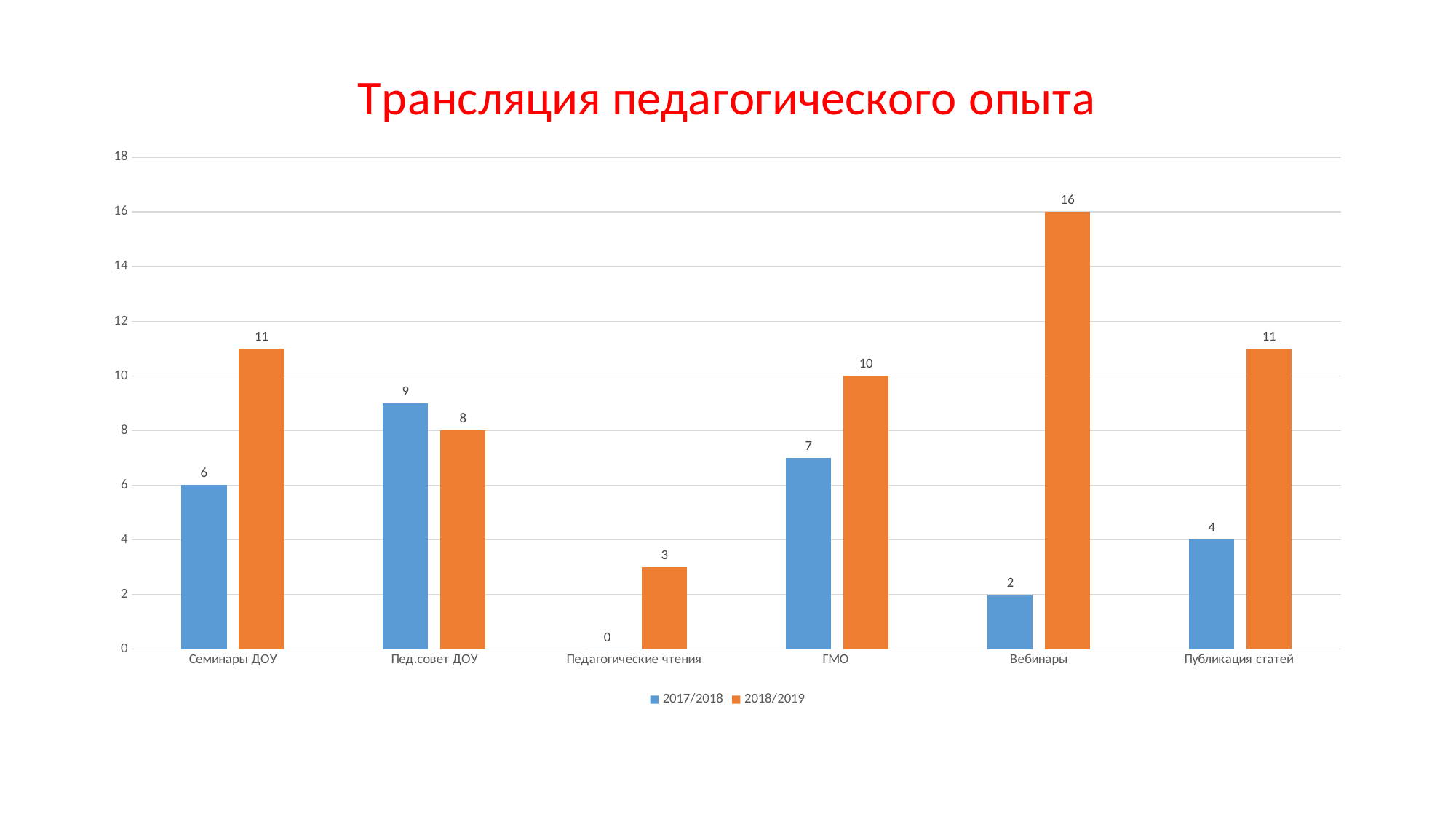
What is the value for Педагогические чтения in the 2017/2018 series? 0 What is the title of the chart? Трансляция педагогического опыта What is the value for Вебинары in the 2018/2019 series? 16 What is the difference between the 2018/2019 and 2017/2018 values for Вебинары? 14 Which category has the highest value in the 2018/2019 series? Вебинары Which is larger for Пед.совет ДОУ: the 2017/2018 value or the 2018/2019 value? 2017/2018 What kind of chart is shown on the slide? Bar chart What is the value for Пед.совет ДОУ in the 2017/2018 series? 9 Which colour represents the 2018/2019 series? Orange How many categories are shown on the x axis? 6 How many series does the legend list? 2 Which category has the lowest value in the 2017/2018 series? Педагогические чтения